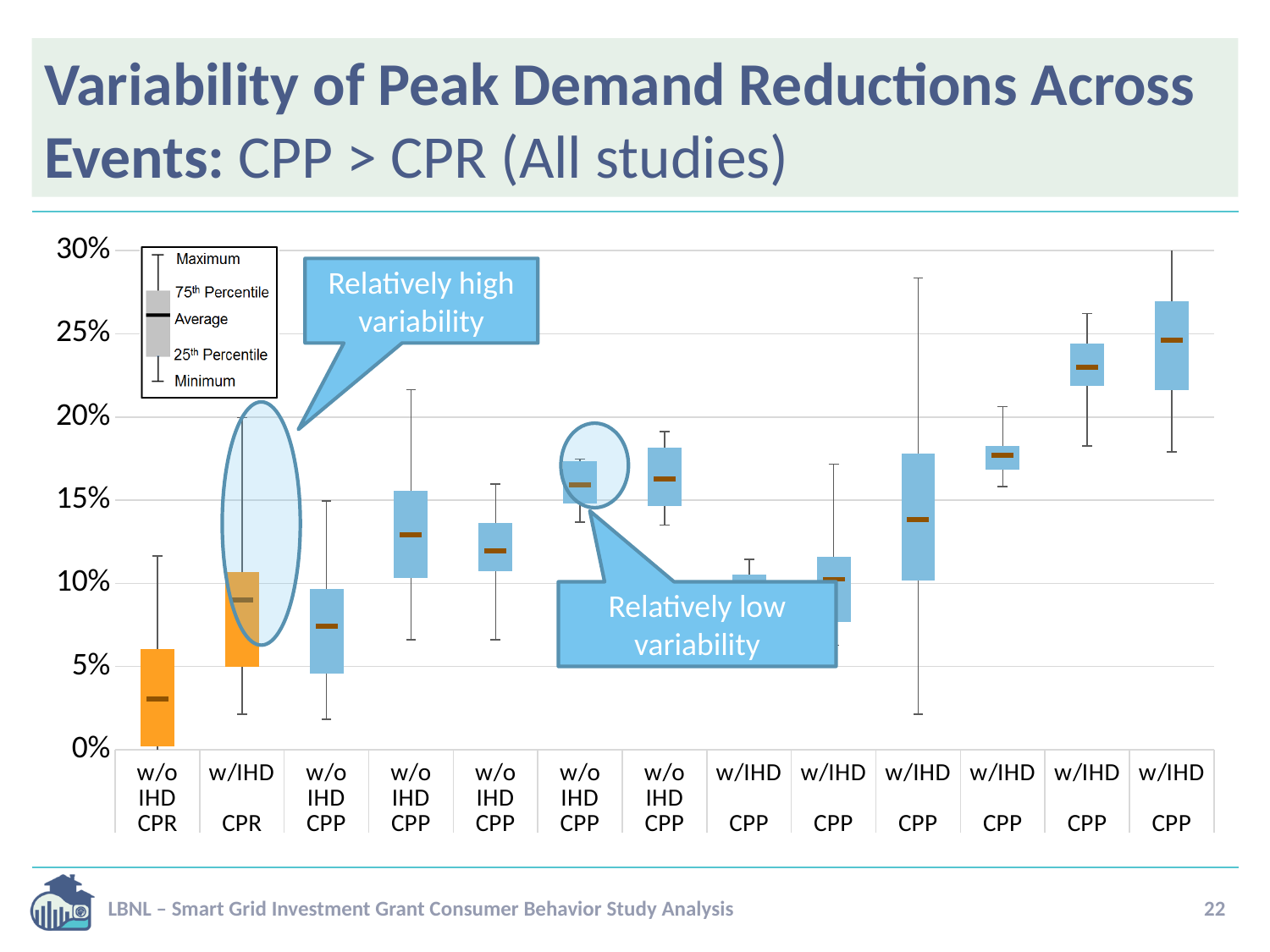
Which box has the highest average? The rightmost w/IHD CPP box Which box has the lowest average (the horizontal marker inside the box)? w/o IHD CPR (leftmost box) How many boxes (categories) are plotted along the x axis? 13 Which has the larger average: the leftmost box (w/o IHD CPR) or the rightmost box (w/IHD CPP)? The rightmost box (w/IHD CPP) Is the average for the rightmost box (w/IHD CPP) greater or less than 20%? greater How many categories on the x axis are labelled w/IHD CPP? 6 Is the maximum whisker of the w/IHD CPR box greater or less than 15%? greater What colour are the CPR boxes compared with the CPP boxes? CPR boxes are orange; CPP boxes are blue Is the average for the leftmost box (w/o IHD CPR) greater or less than 5%? less What kind of chart is shown on the slide? Box-and-whisker (box plot) chart What five statistics does the chart legend list for each box? Maximum, 75th Percentile, Average, 25th Percentile, Minimum How many categories on the x axis are labelled CPR? 2